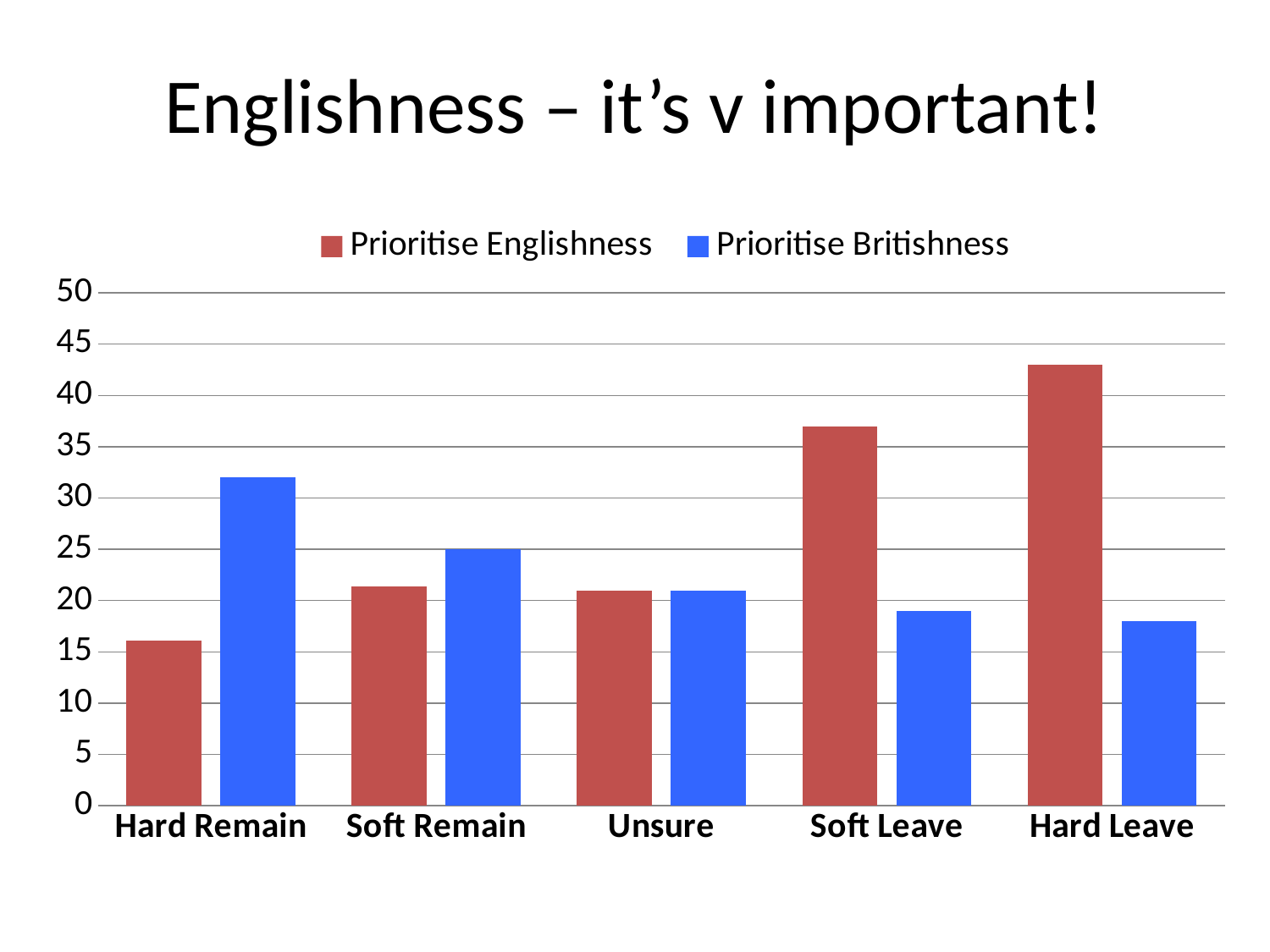
Is the Prioritise Englishness value for Hard Remain greater or less than 20? less What kind of chart is shown on the slide? bar chart Is the Prioritise Englishness value for Hard Leave greater or less than 40? greater For Hard Leave, which is larger: Prioritise Englishness or Prioritise Britishness? Prioritise Englishness What is the title of the slide? Englishness – it’s v important! How many categories are shown on the x axis? 5 How many series does the legend list? 2 Which category has the lowest value for Prioritise Englishness? Hard Remain For Hard Remain, which is larger: Prioritise Englishness or Prioritise Britishness? Prioritise Britishness Does the Prioritise Britishness series generally rise or fall from Hard Remain to Hard Leave? fall Which category has the highest value for Prioritise Englishness? Hard Leave Which category has the highest value for Prioritise Britishness? Hard Remain